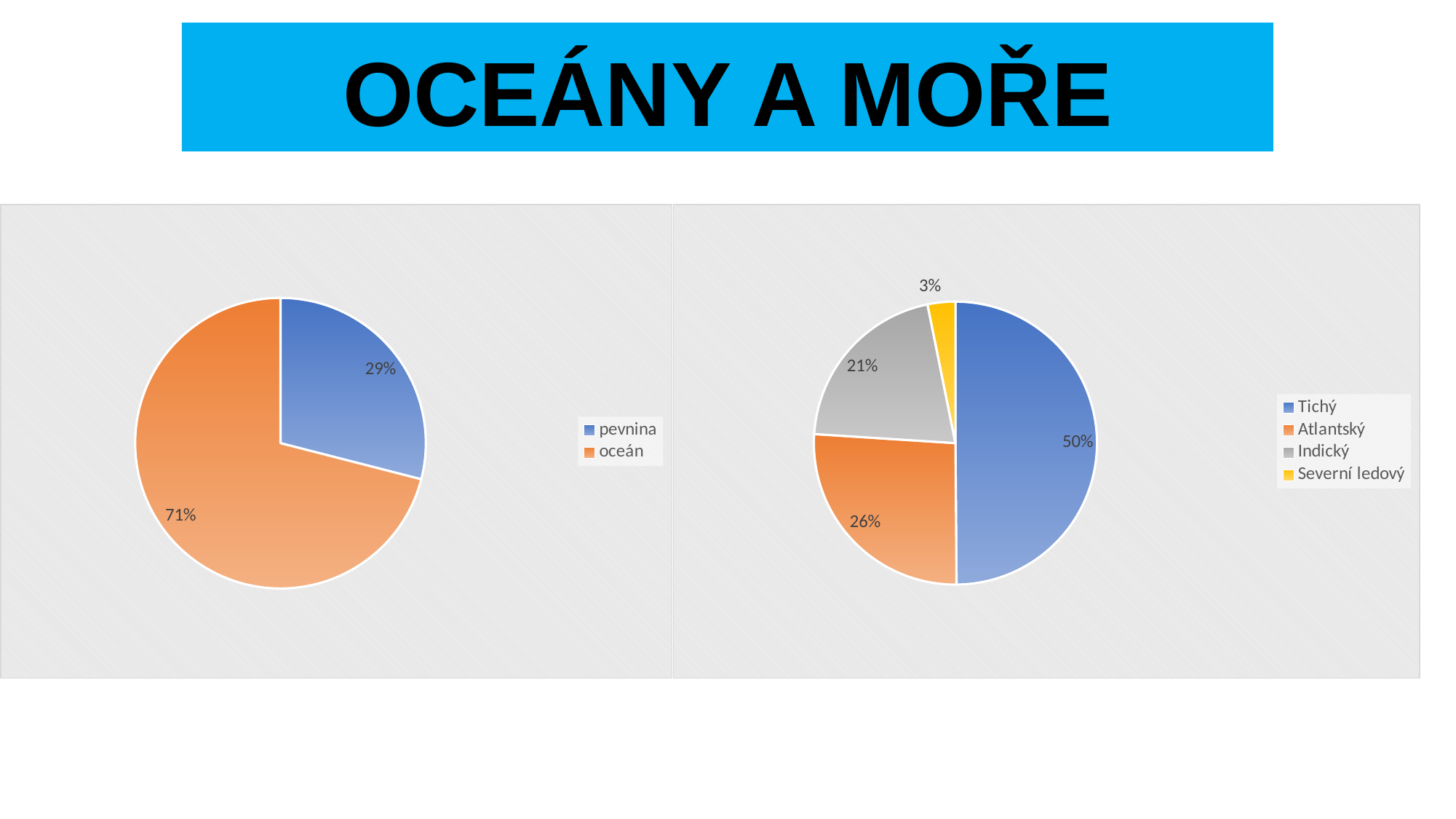
In the right pie chart, what share does Severní ledový have? 3% In the left pie chart, which category has the larger slice? oceán In the right pie chart, what share does Atlantský have? 26% In the right pie chart, what is the difference between the Tichý and Indický shares? 29% In the left pie chart, what share does pevnina have? 29% In the right pie chart, what share does Tichý have? 50% In the left pie chart, how many categories does the legend list? 2 What type of chart is shown on the right side of the slide? pie chart In the left pie chart, what is the difference between the oceán and pevnina shares? 42% In the right pie chart, which is larger, Atlantský or Indický? Atlantský In the right pie chart, which category has the smallest slice? Severní ledový In the left pie chart, what share does oceán have? 71%